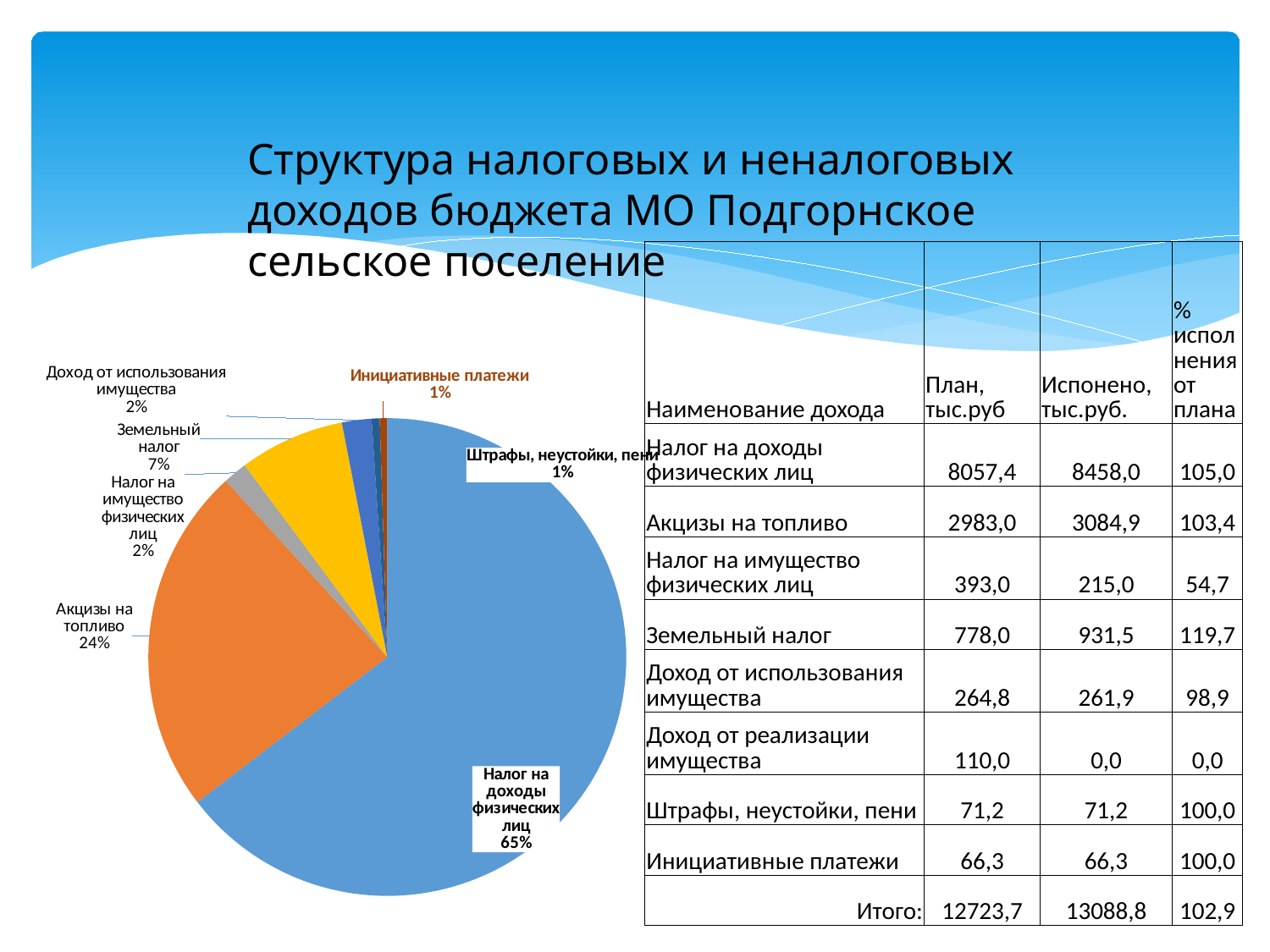
What is the difference in percentage points between the shares of "Налог на доходы физических лиц" and "Акцизы на топливо"? 41 Which is larger in the pie chart: "Акцизы на топливо" or "Земельный налог"? Акцизы на топливо What share of the pie does "Инициативные платежи" have? 1% How many labelled slices does the pie chart have? 7 What is the share of "Штрафы, неустойки, пени" in the pie chart? 1% What colour is the largest slice of the pie chart? blue What share of the pie does "Акцизы на топливо" have? 24% Which slice of the pie chart is the largest? Налог на доходы физических лиц What kind of chart is shown on the slide? pie chart